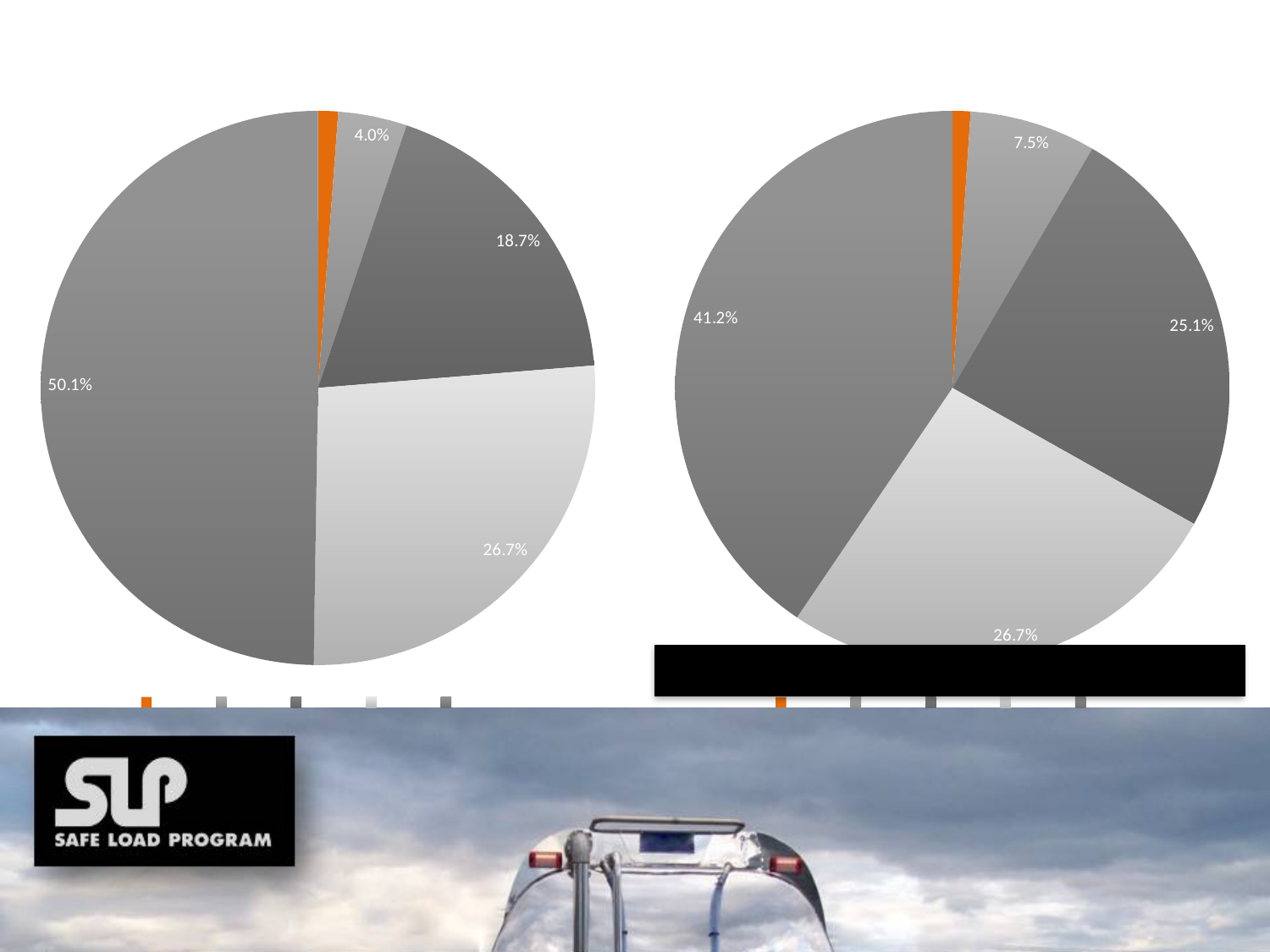
Which chart has the larger biggest slice, the pie chart on the left or the pie chart on the right? the pie chart on the left In the pie chart on the left, what is the value of the largest slice? 50.1% In the pie chart on the right, what is the value of the small light grey slice at the top, next to the orange slice? 7.5% In the pie chart on the left, what is the difference between the 50.1% slice and the 26.7% slice? 23.4 percentage points How many slices does the pie chart on the right of the slide have? 5 In the pie chart on the right, what is the difference between the 26.7% slice and the 25.1% slice? 1.6 percentage points In the pie chart on the left, what colour is the thinnest slice at the top? orange How many slices does the pie chart on the left of the slide have? 5 In the pie chart on the left, what is the value of the dark grey slice in the upper right? 18.7% In the pie chart on the right, what is the value of the largest slice? 41.2% What kind of chart is the chart on the left of the slide? pie chart In the pie chart on the left, what is the value of the lightest grey slice at the bottom right? 26.7%